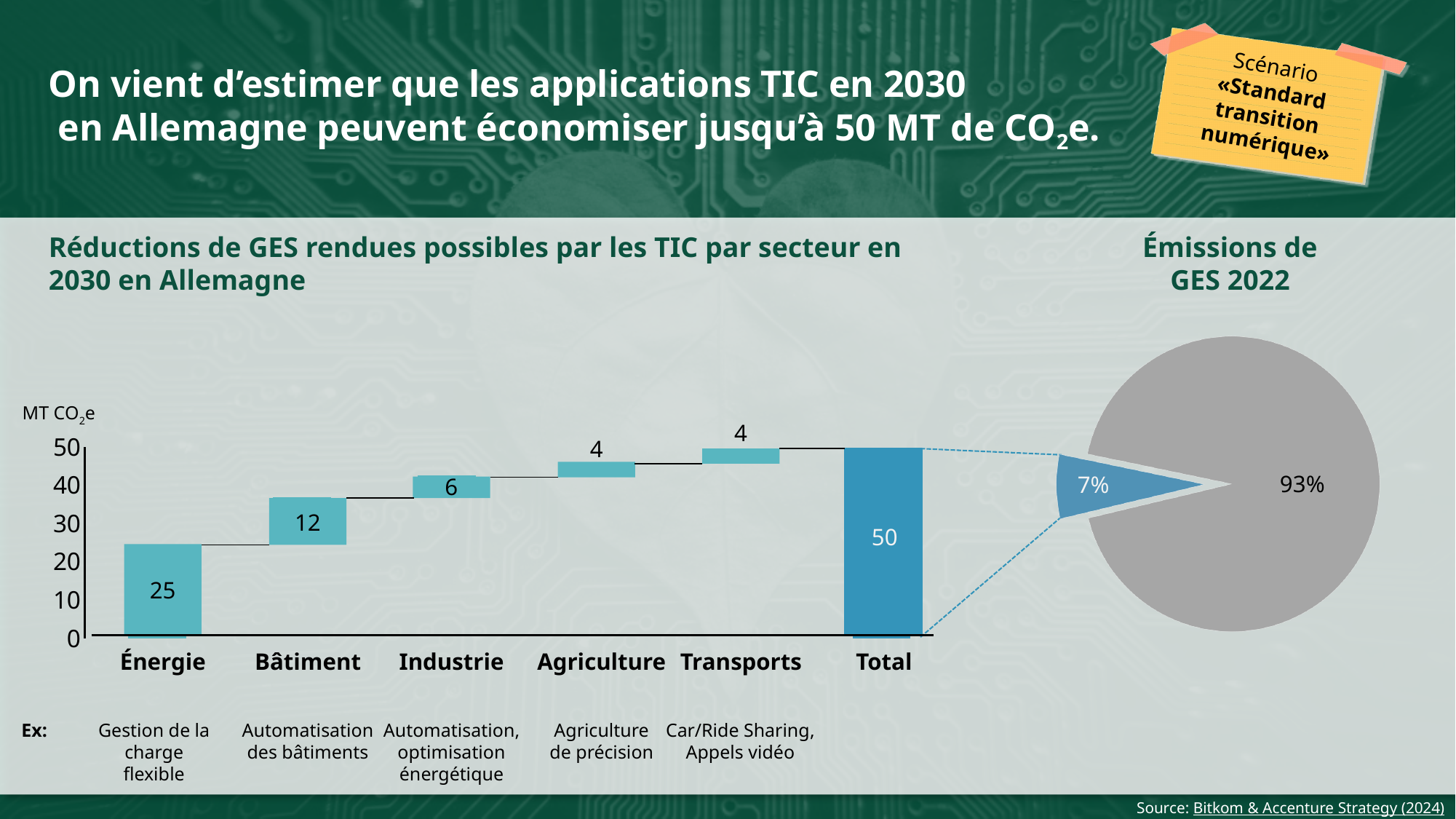
In the chart 'Réductions de GES rendues possibles par les TIC par secteur en 2030 en Allemagne', what is the difference between the values for Énergie and Bâtiment? 13 In the chart 'Réductions de GES rendues possibles par les TIC par secteur en 2030 en Allemagne', how many sector categories are shown, excluding Total? 5 In the chart 'Réductions de GES rendues possibles par les TIC par secteur en 2030 en Allemagne', what is the value for Bâtiment? 12 In the chart 'Réductions de GES rendues possibles par les TIC par secteur en 2030 en Allemagne', what is the value of the Total bar? 50 What kind of chart is 'Réductions de GES rendues possibles par les TIC par secteur en 2030 en Allemagne'? Bar chart (waterfall) In the pie chart 'Émissions de GES 2022', what share does the blue slice represent? 7% In the pie chart 'Émissions de GES 2022', what share does the grey slice represent? 93% In the chart 'Réductions de GES rendues possibles par les TIC par secteur en 2030 en Allemagne', what unit is shown on the y axis? MT CO2e In the chart 'Réductions de GES rendues possibles par les TIC par secteur en 2030 en Allemagne', which is larger, the value for Bâtiment or the value for Industrie? Bâtiment In the chart 'Réductions de GES rendues possibles par les TIC par secteur en 2030 en Allemagne', what is the value for Industrie? 6 In the chart 'Réductions de GES rendues possibles par les TIC par secteur en 2030 en Allemagne', which sector has the largest reduction? Énergie In the chart 'Réductions de GES rendues possibles par les TIC par secteur en 2030 en Allemagne', what is the value for Énergie? 25